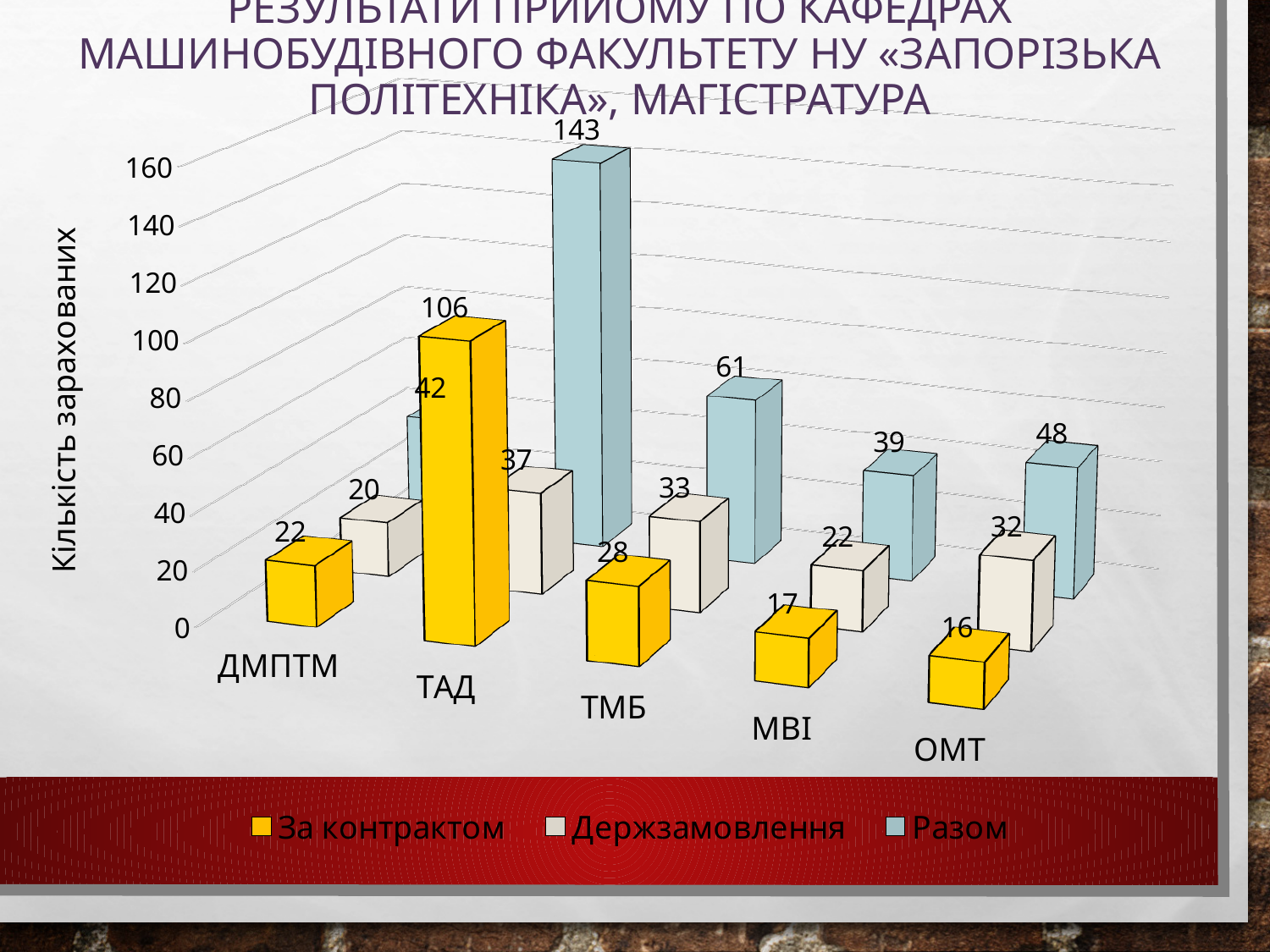
How many series does the legend list? 3 Is the Разом value for ОМТ greater or less than 40? greater What is the value for За контрактом for ТАД? 106 What is the difference between the Разом values for ТАД and ТМБ? 82 Which category has the lowest За контрактом value? ОМТ What kind of chart is shown on the slide? bar chart Which category has the highest Разом value? ТАД What is the value for Разом for ТМБ? 61 What is the value for Держзамовлення for ОМТ? 32 What is the label of the vertical axis? Кількість зарахованих How many categories are shown on the x axis? 5 Which is larger for МВІ: За контрактом or Держзамовлення? Держзамовлення